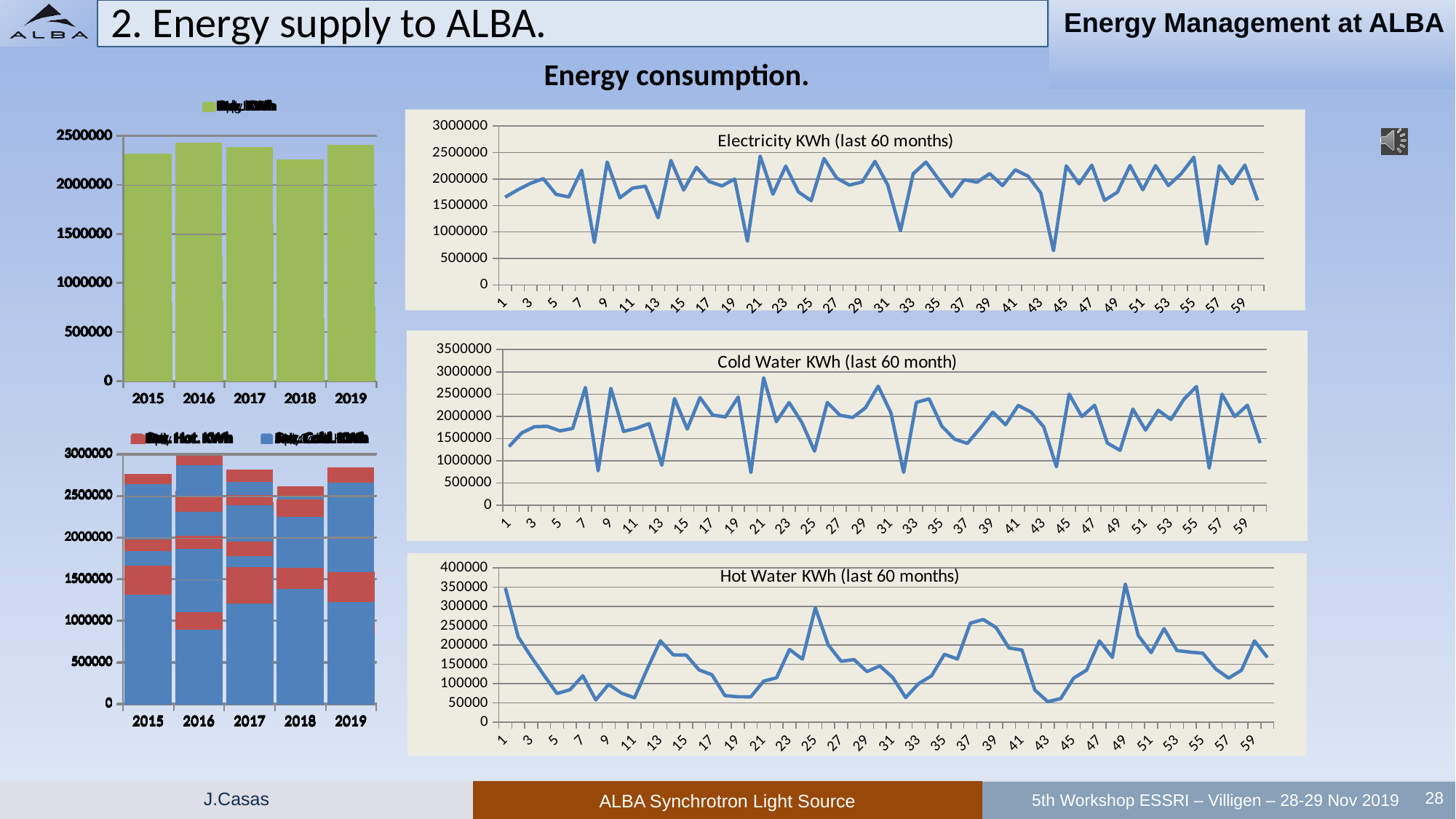
How many categories are shown on the x axis of the top-left bar chart? 5 In the 'Hot Water KWh (last 60 months)' chart, do the values rise or fall from month 1 to month 5? fall In the 'Hot Water KWh (last 60 months)' chart, is the value at month 43 greater or less than 100000? less In the 'Electricity KWh (last 60 months)' chart, is the value at month 21 greater or less than 2000000? greater How many monthly data points does the 'Hot Water KWh (last 60 months)' chart plot? 60 In the top-left bar chart, is the value for 2018 greater or less than 2000000? greater What kind of chart is the 'Electricity KWh (last 60 months)' chart? line chart In the 'Electricity KWh (last 60 months)' chart, which month has the lowest value? 44 In the 'Hot Water KWh (last 60 months)' chart, which is larger, the value at month 1 or the value at month 43? month 1 What kind of chart is the top-left chart with years 2015 to 2019? bar chart